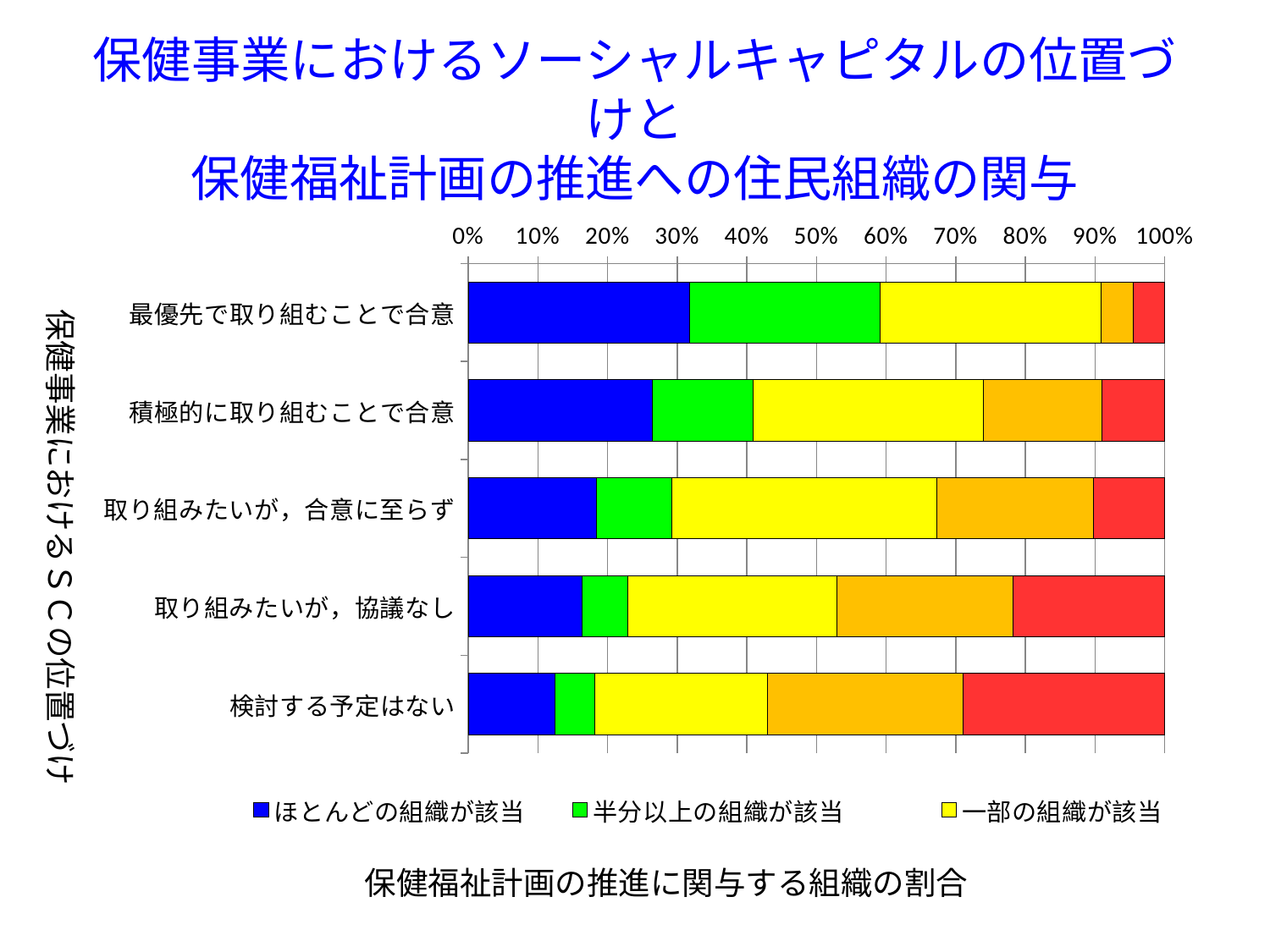
Is the green (半分以上の組織が該当) segment for 最優先で取り組むことで合意 greater or less than 20%? greater How many categories are plotted on the vertical axis of the chart? 5 What kind of chart is shown on the slide? Stacked bar chart Moving down the categories from 最優先で取り組むことで合意 to 検討する予定はない, does the blue (ほとんどの組織が該当) segment increase or decrease? decrease Is the blue (ほとんどの組織が該当) segment for 最優先で取り組むことで合意 greater or less than 20%? greater Which category has the largest red segment at the right end of its bar? 検討する予定はない How many entries does the chart's legend list? 3 Is the blue (ほとんどの組織が該当) segment for 検討する予定はない greater or less than 20%? less What is the title of the horizontal axis of the chart? 保健福祉計画の推進に関与する組織の割合 Which has the larger blue (ほとんどの組織が該当) segment: 積極的に取り組むことで合意 or 取り組みたいが，協議なし? 積極的に取り組むことで合意 Which category has the smallest blue (ほとんどの組織が該当) segment? 検討する予定はない Which category has the largest blue (ほとんどの組織が該当) segment? 最優先で取り組むことで合意